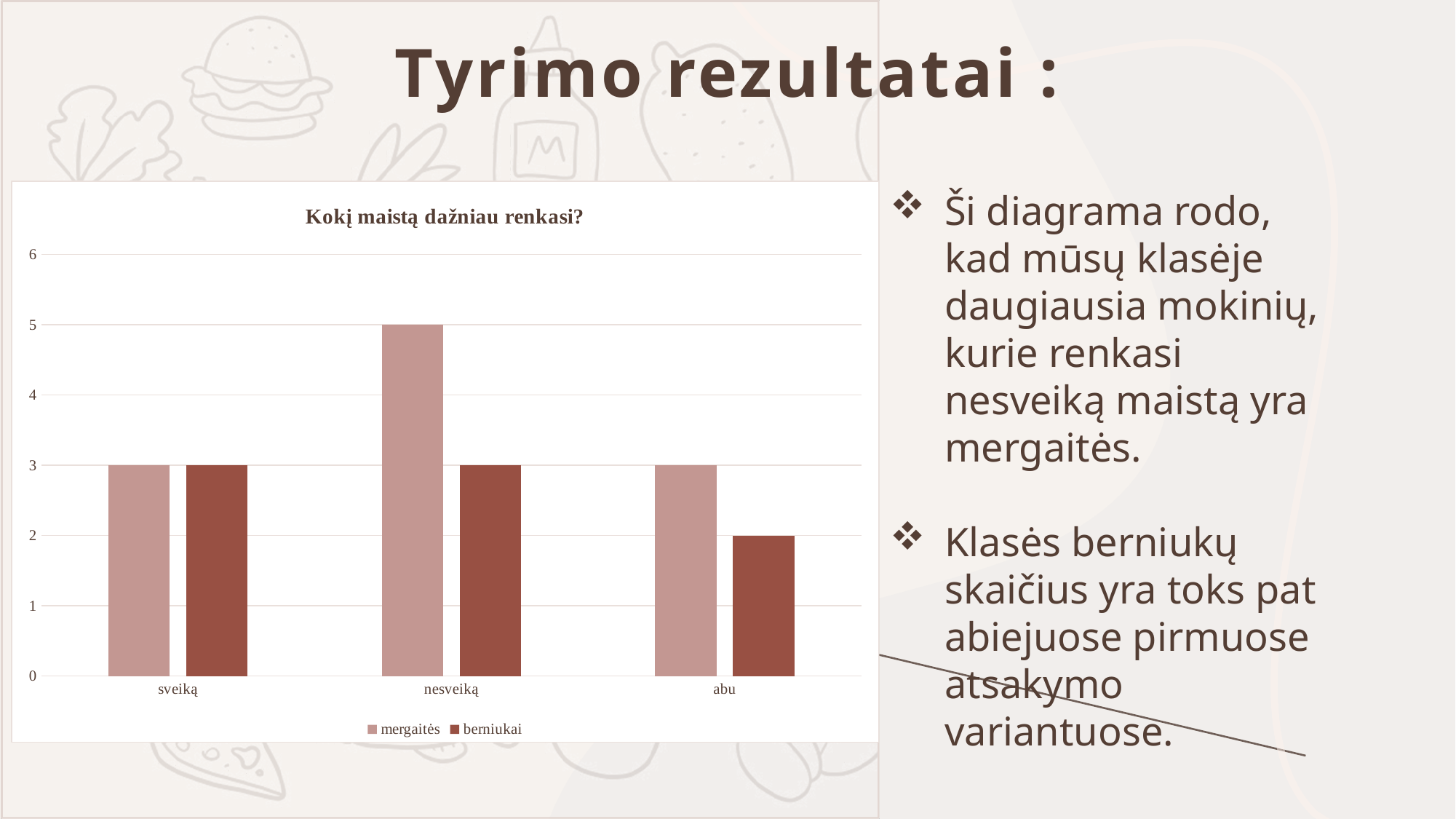
Which category has the highest value for mergaitės? nesveiką What is the difference between mergaitės and berniukai in the nesveiką category? 2 How many categories are shown on the x axis? 3 What is the value for berniukai in the sveiką category? 3 What is the value for mergaitės in the nesveiką category? 5 What is the value for berniukai in the abu category? 2 What type of chart is shown on the slide? bar chart What is the title of the chart? Kokį maistą dažniau renkasi? Which category has the lowest value for berniukai? abu How many series does the legend list? 2 Is the value for mergaitės in the nesveiką category greater or less than 4? greater In the abu category, which series has the larger value, mergaitės or berniukai? mergaitės